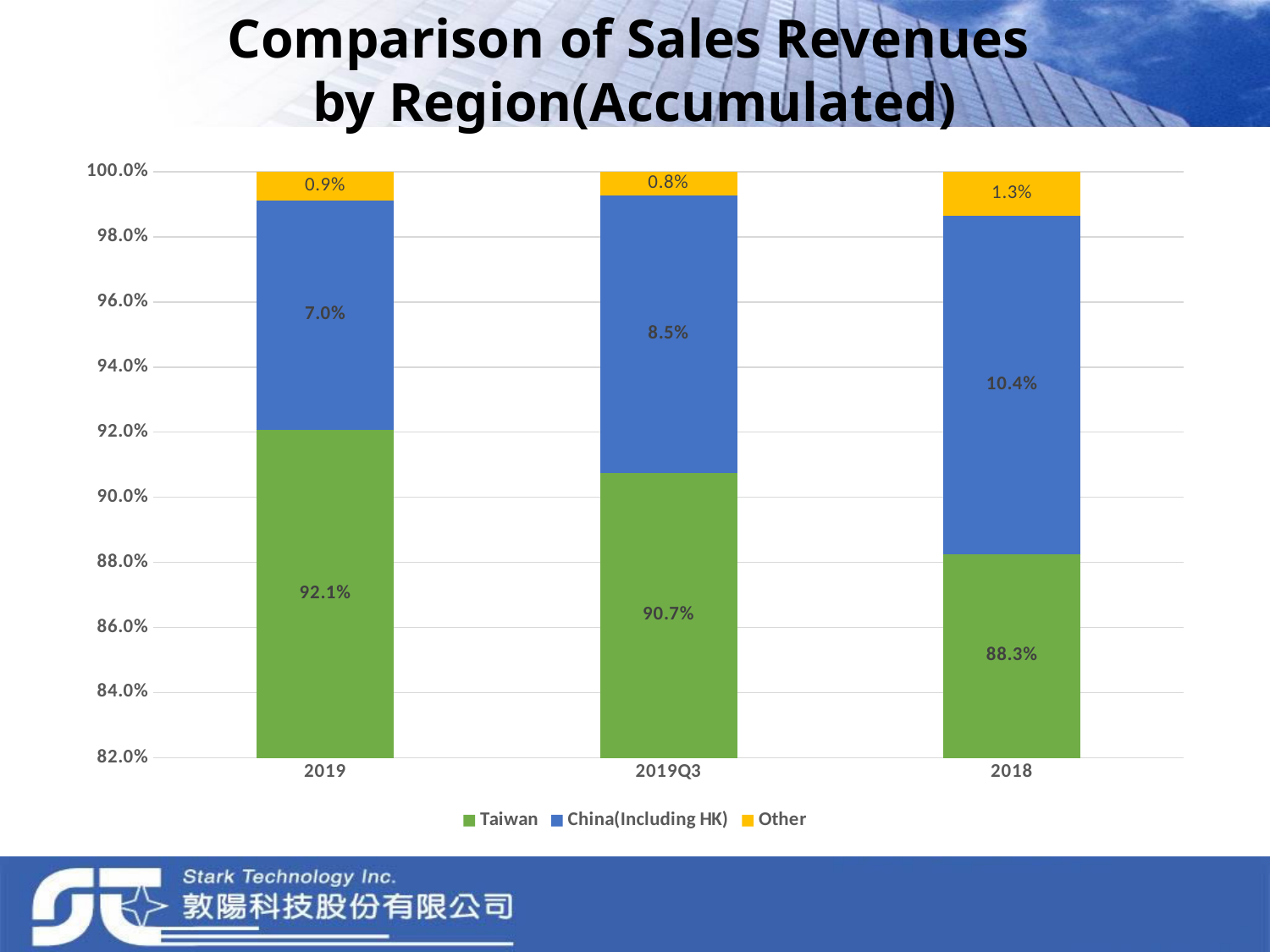
What is the difference between the China(Including HK) share in 2018 and in 2019? 3.4% What kind of chart is shown on the slide? Stacked bar chart How many series does the legend list? 3 What is the difference between the Taiwan share in 2019 and in 2018? 3.8% What is the China(Including HK) share of sales revenue for 2018? 10.4% Which is larger, the China(Including HK) share in 2019Q3 or in 2019? 2019Q3 How many periods are shown on the x axis? 3 Which period has the highest Taiwan share? 2019 Which period has the lowest Other share? 2019Q3 What is the Taiwan share of sales revenue for 2019? 92.1% What is the Other share of sales revenue for 2019Q3? 0.8% Does the Taiwan share rise or fall moving left to right along the x axis? Fall